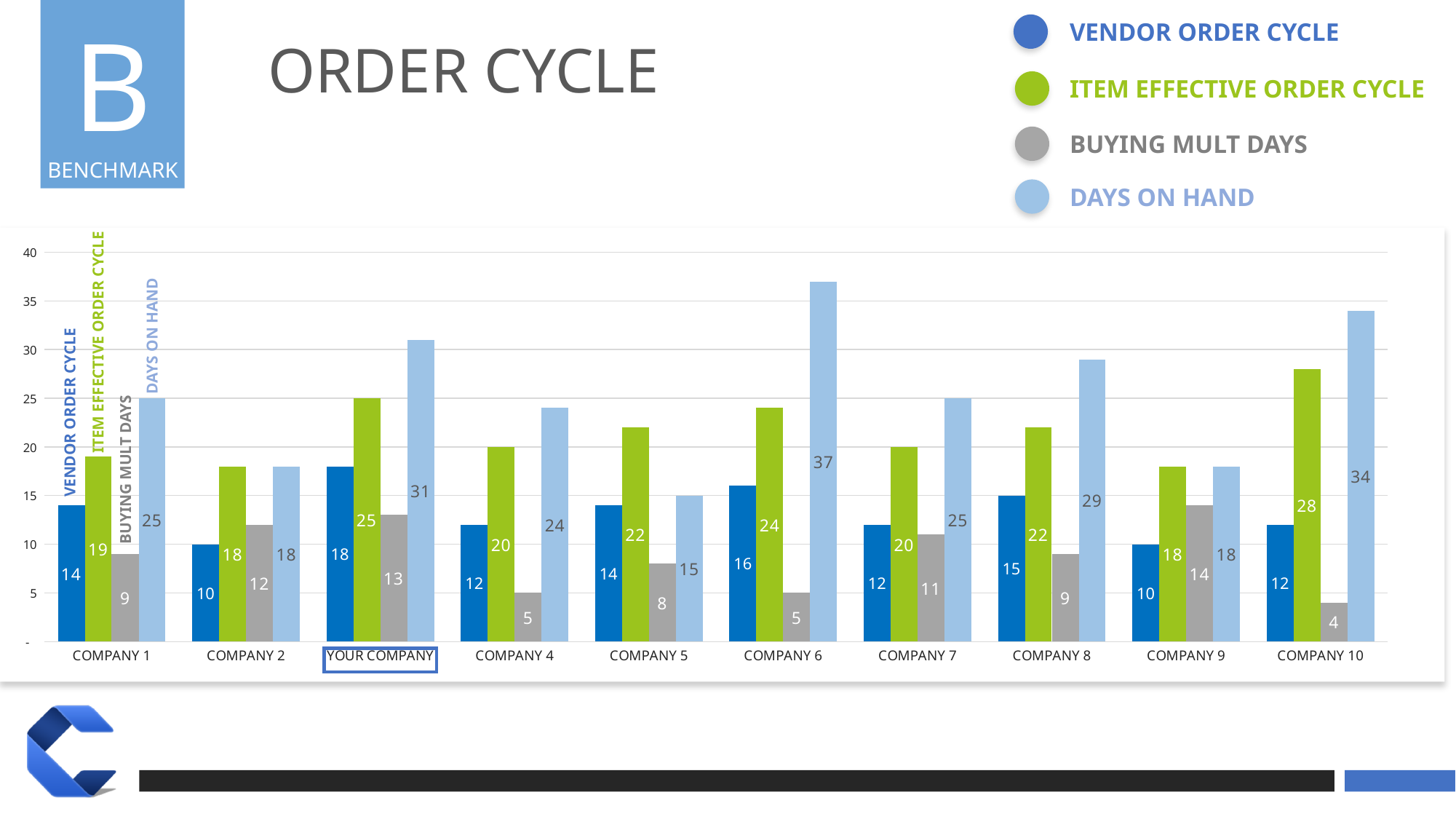
What kind of chart is shown on the slide? Bar chart How many series does the legend list? 4 What is the Days on Hand value for Company 6? 37 What is the difference between the Days on Hand values for Company 6 and Company 5? 22 How many companies are shown on the x axis? 10 What is the Item Effective Order Cycle value for Your Company? 25 What is the Buying Mult Days value for Company 10? 4 Which company has the lowest Buying Mult Days value? Company 10 What is the Vendor Order Cycle value for Company 8? 15 Which is larger, the Vendor Order Cycle for Your Company or for Company 4? Your Company Which company has the highest Item Effective Order Cycle value? Company 10 Which company has the highest Days on Hand value? Company 6